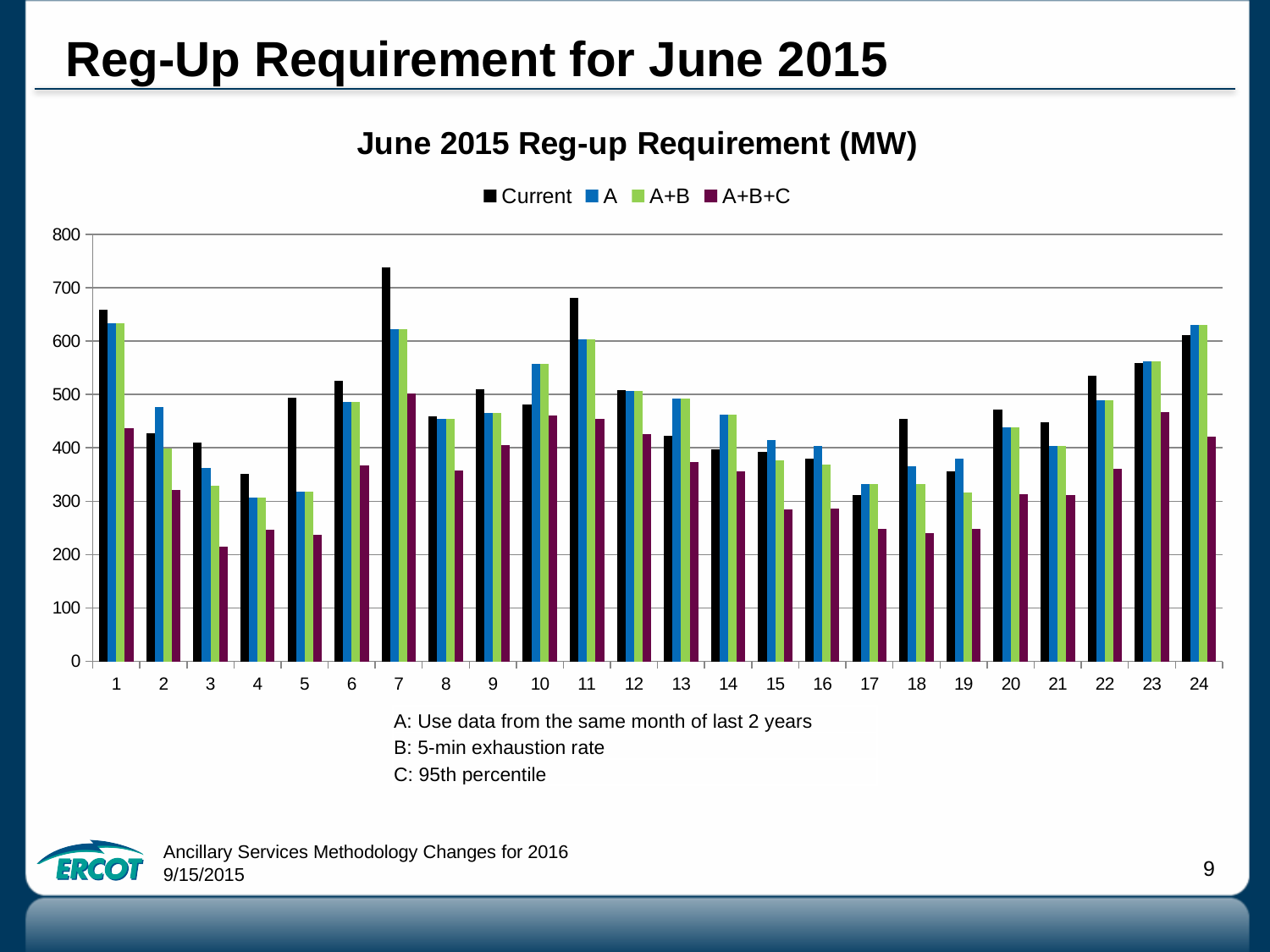
For the Current series, which category has the highest value? 7 What kind of chart is shown on the slide? Bar chart Which series is shown in black in the legend? Current How many series does the legend list? 4 For the A+B+C series, which category has the lowest value? 3 Is the Current value for category 17 greater or less than 400? less How many categories are shown along the x axis? 24 For the A+B+C series, which category has the highest value? 7 Is the Current value for category 7 greater or less than 700? greater What is the title of the chart? June 2015 Reg-up Requirement (MW) At category 14, which is larger: the Current value or the A value? A Is the A+B+C value for category 3 greater or less than 300? less